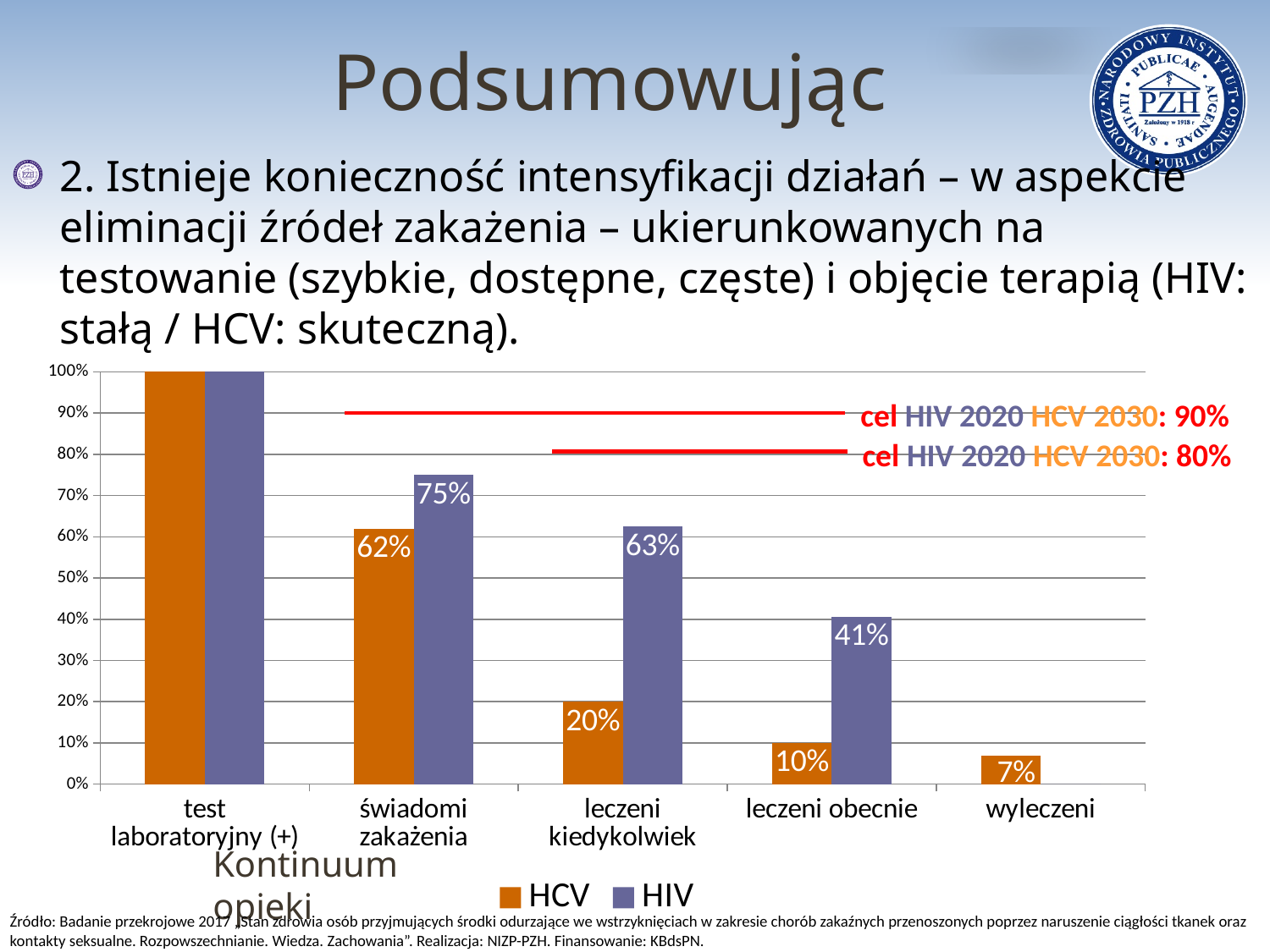
Is the HIV value for "leczeni obecnie" greater or less than 50%? less Among the labelled HCV bars, which category has the lowest value? wyleczeni What is the HIV value for "świadomi zakażenia"? 75% How many series does the legend list? 2 What is the HCV value for "świadomi zakażenia"? 62% What is the HCV value for "leczeni obecnie"? 10% How many categories are shown on the x axis? 5 What is the HCV value for "wyleczeni"? 7% What is the HIV value for "leczeni kiedykolwiek"? 63% Which is larger for "leczeni obecnie", the HCV value or the HIV value? HIV What is the difference between the HIV and HCV values for "leczeni kiedykolwiek"? 43 percentage points What kind of chart is shown on the slide? bar chart